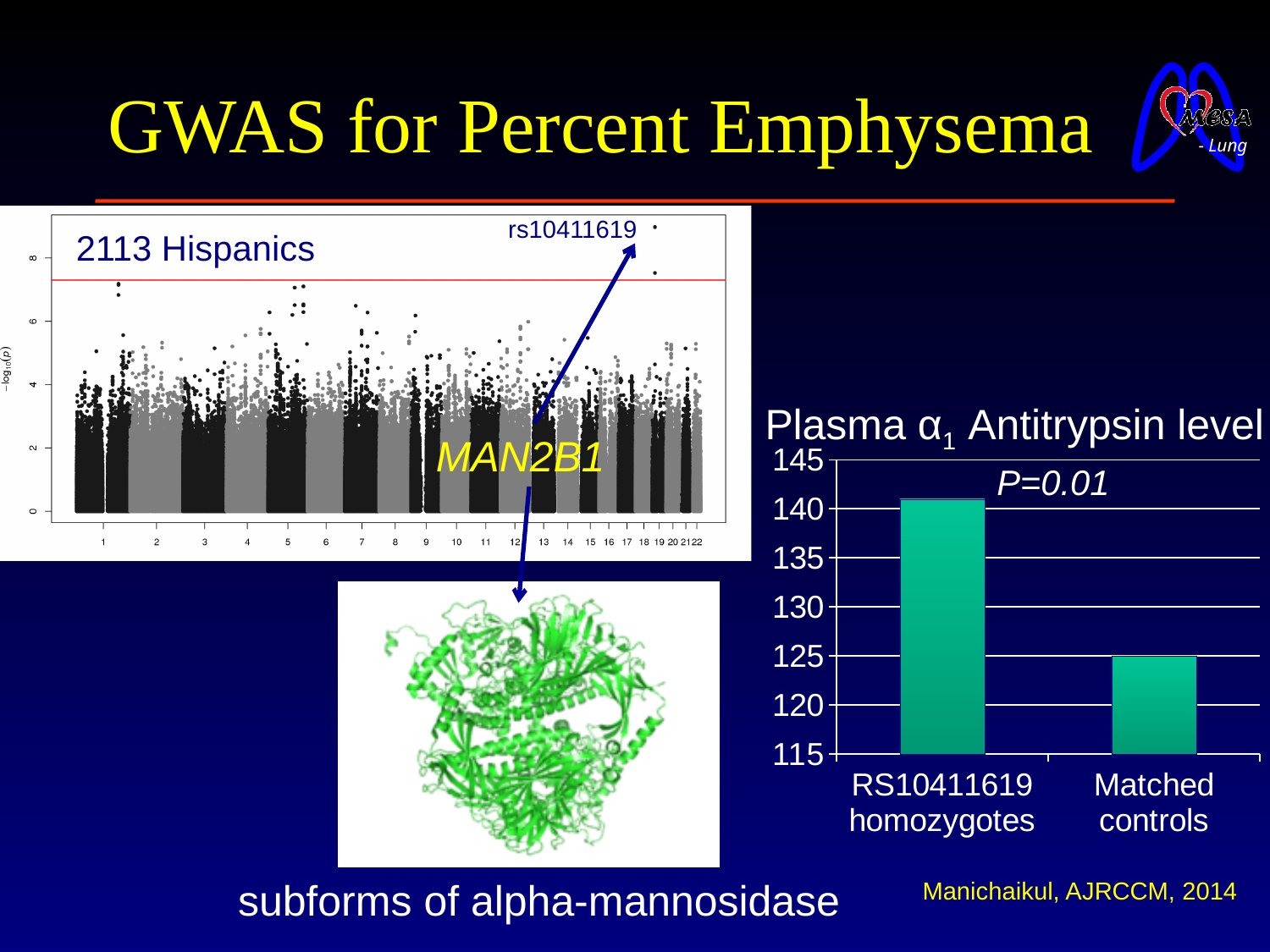
What P value is printed on the 'Plasma α1 Antitrypsin level' bar chart? P=0.01 In the 'Plasma α1 Antitrypsin level' bar chart, which category has the lowest value? Matched controls In the Manhattan plot on the left of the slide, which SNP is labelled at the top of the plot? rs10411619 In the 'Plasma α1 Antitrypsin level' bar chart, which category has the highest value? RS10411619 homozygotes How many categories are shown on the x axis of the 'Plasma α1 Antitrypsin level' bar chart? 2 In the Manhattan plot on the left of the slide, how many chromosomes are labelled along the x axis? 22 What is the lowest value shown on the y axis of the 'Plasma α1 Antitrypsin level' bar chart? 115 In the 'Plasma α1 Antitrypsin level' bar chart, is the value for Matched controls greater or less than 130? less What kind of chart is the plot on the left of the slide labelled '2113 Hispanics'? scatter plot (Manhattan plot) In the 'Plasma α1 Antitrypsin level' bar chart, which is larger: the value for RS10411619 homozygotes or the value for Matched controls? RS10411619 homozygotes What kind of chart is the 'Plasma α1 Antitrypsin level' chart on the right of the slide? bar chart